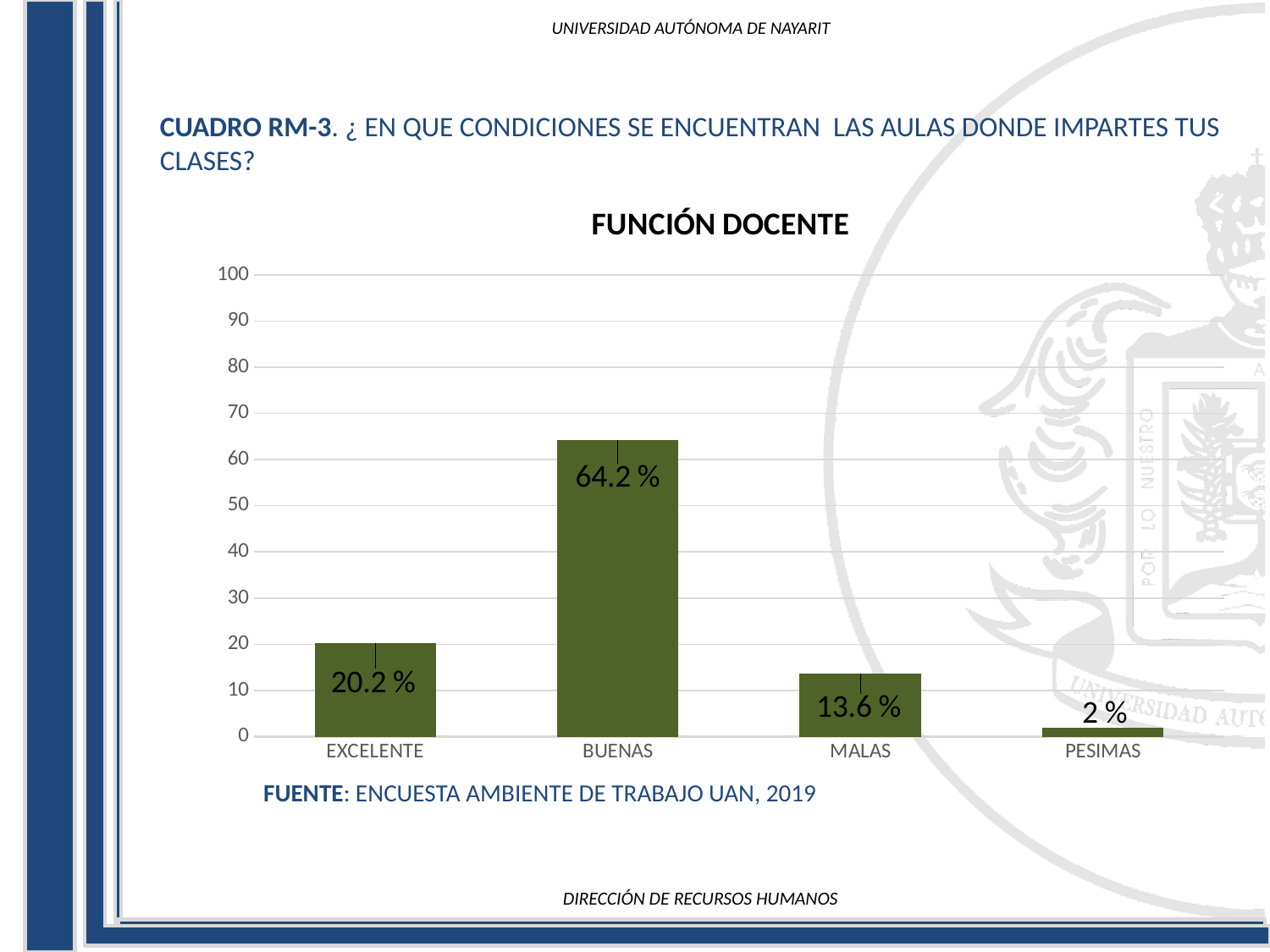
What is the value for EXCELENTE? 20.2 % Which is larger, the value for EXCELENTE or the value for MALAS? EXCELENTE What is the difference between the values for BUENAS and EXCELENTE? 44 % What kind of chart is shown? bar chart What is the value for PESIMAS? 2 % Which category has the highest value? BUENAS Which category has the lowest value? PESIMAS What is the title of the chart? FUNCIÓN DOCENTE Is the value for BUENAS greater or less than 60? greater How many categories are shown on the x axis? 4 What is the value for BUENAS? 64.2 % What is the value for MALAS? 13.6 %